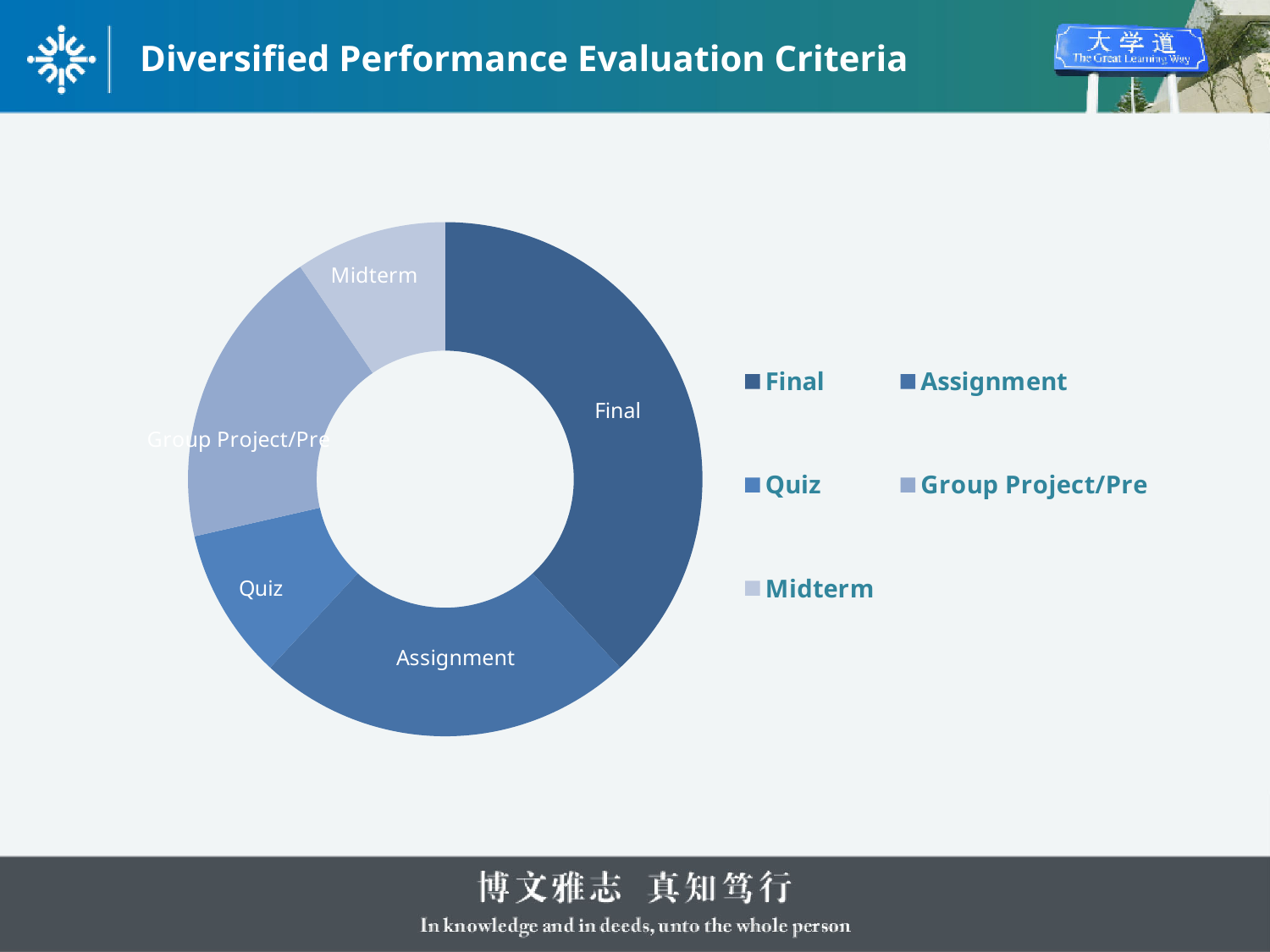
Which category takes up the largest share of the chart? Final What kind of chart is shown on the slide? Doughnut (pie) chart Which is larger, the share for Assignment or the share for Midterm? Assignment What is the title of the slide containing the chart? Diversified Performance Evaluation Criteria Which is larger, the share for Assignment or the share for Group Project/Pre? Assignment How many categories (slices) does the chart show? 5 How many entries does the chart's legend list? 5 Which is larger, the share for Final or the share for Assignment? Final Which category is listed last in the chart's legend? Midterm